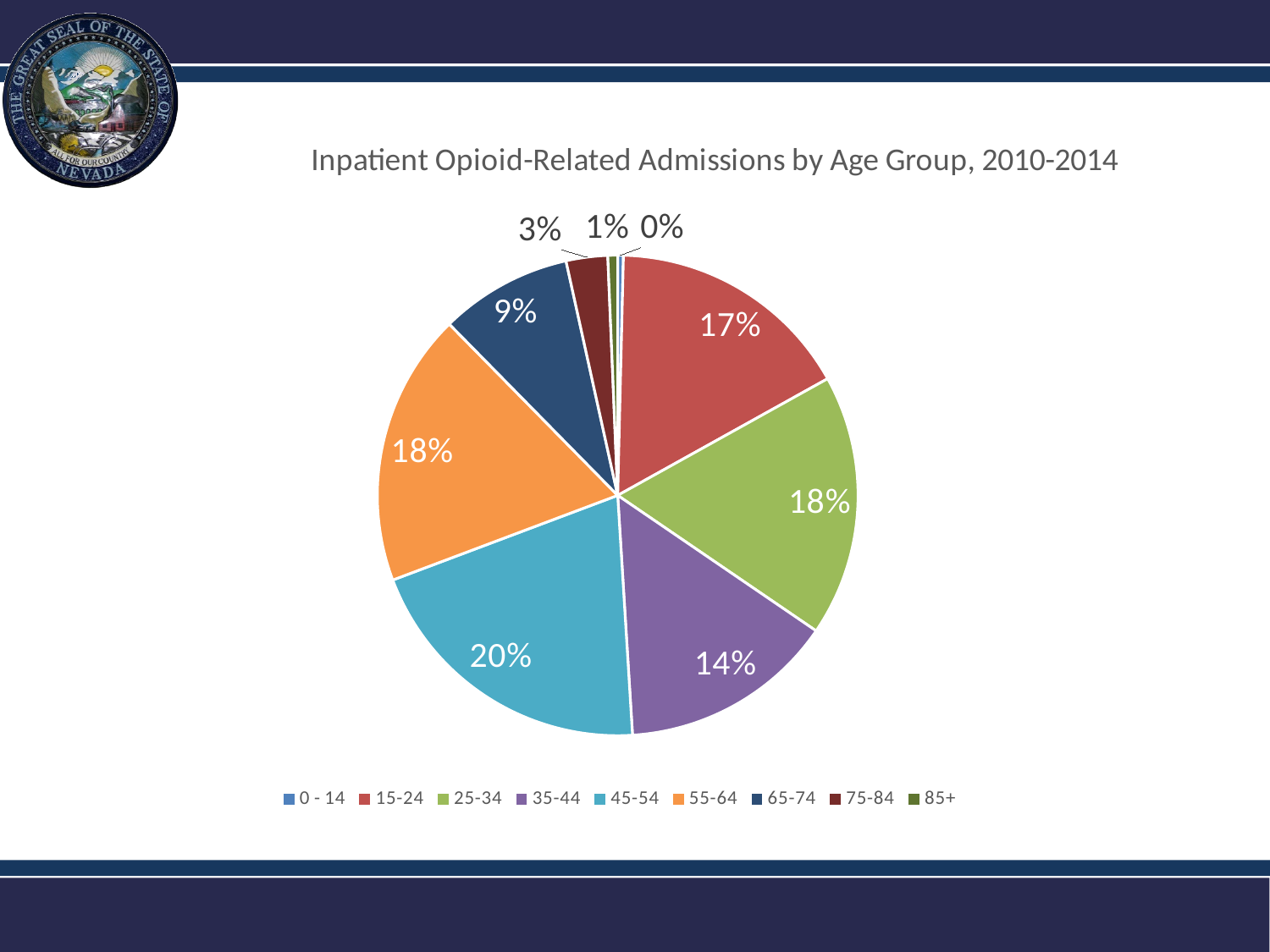
What is the difference in share between the 45-54 and 35-44 age groups? 6% What is the title of the chart? Inpatient Opioid-Related Admissions by Age Group, 2010-2014 What share of admissions is for the 35-44 age group? 14% What share of admissions is for the 65-74 age group? 9% What share of admissions is for the 75-84 age group? 3% What share of admissions is for the 15-24 age group? 17% Which has a larger share of admissions, the 15-24 age group or the 65-74 age group? 15-24 How many age groups are shown in the pie chart? 9 Which age group has the smallest share of admissions? 0 - 14 What kind of chart is shown on the slide? pie chart What share of inpatient opioid-related admissions is for the 45-54 age group? 20% Which age group has the largest share of admissions? 45-54